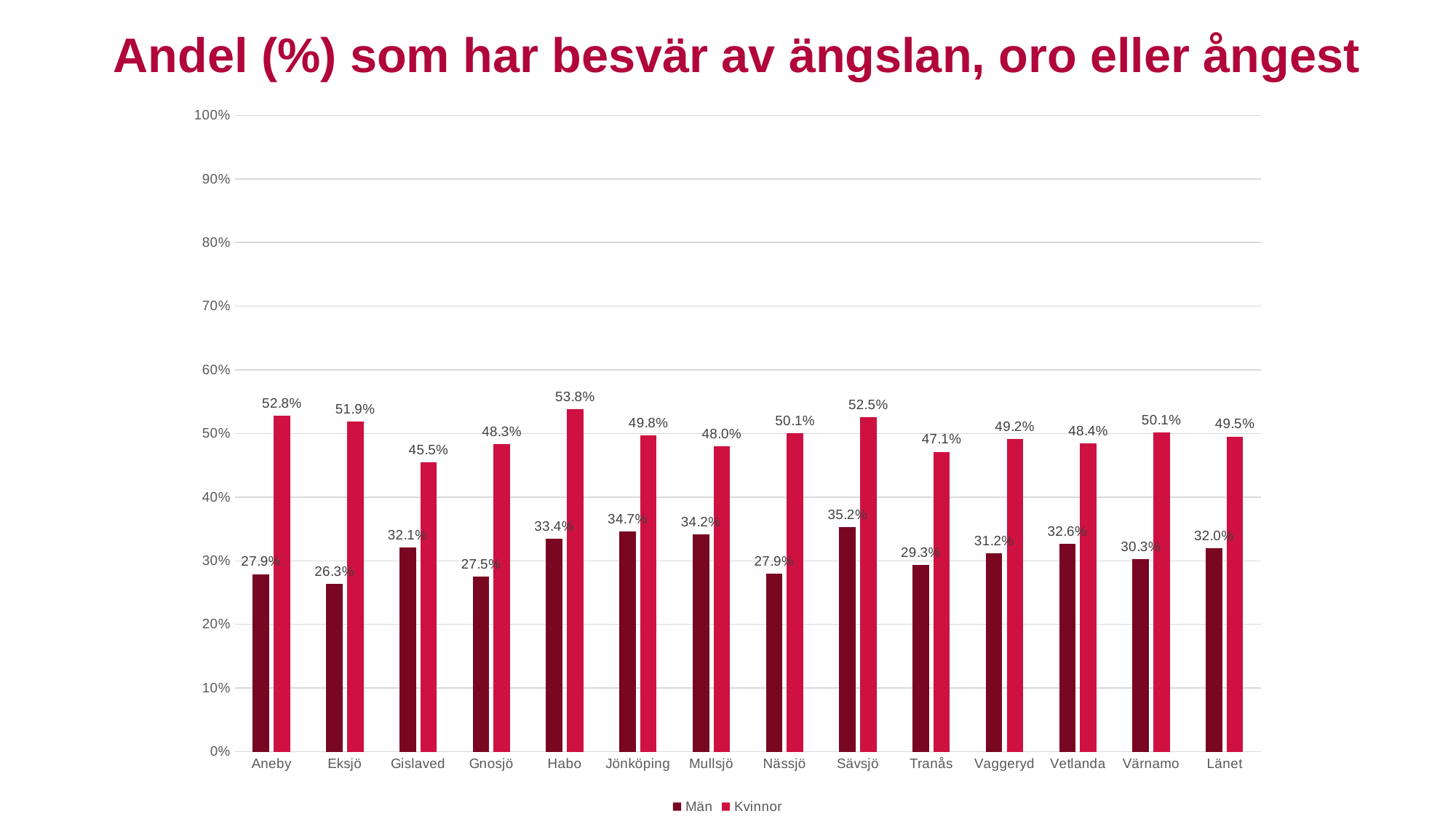
Which municipality has the highest value for Kvinnor? Habo What is the value for Kvinnor in Habo? 53.8% What is the value for Män in Länet? 32.0% How many categories are shown on the x axis? 14 Which category has the highest value for Män? Sävsjö What kind of chart is shown on the slide? Bar chart Which category has the lowest value for Män? Eksjö Which is larger in Gnosjö: the value for Män or the value for Kvinnor? Kvinnor What is the difference between the Kvinnor and Män values for Länet? 17.5 percentage points Which municipality has the lowest value for Kvinnor? Gislaved How many series does the legend list? 2 What is the value for Män in Eksjö? 26.3%